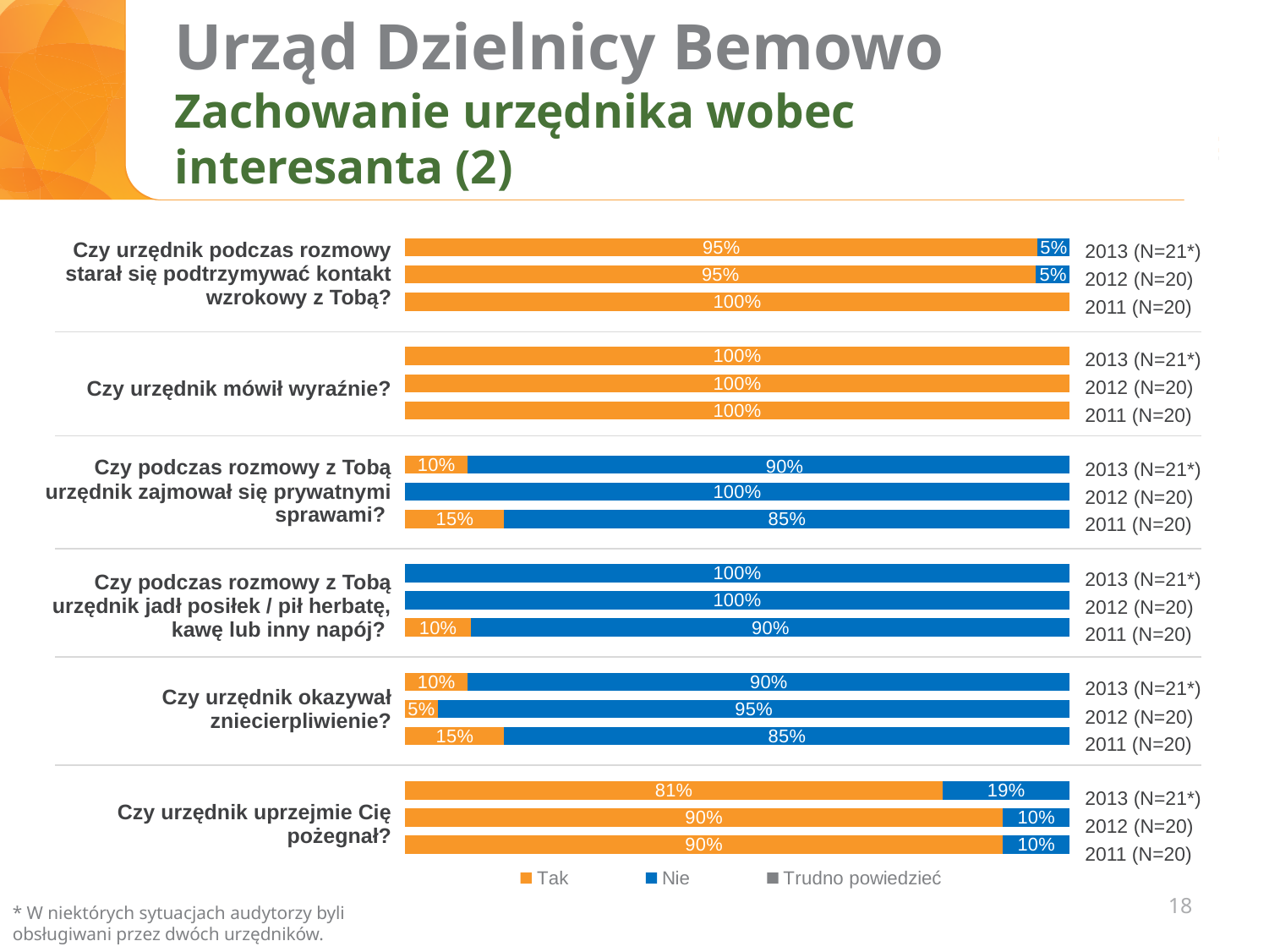
What percentage answered "Tak" to "Czy urzędnik uprzejmie Cię pożegnał?" in 2013? 81% What percentage answered "Tak" to "Czy podczas rozmowy z Tobą urzędnik zajmował się prywatnymi sprawami?" in 2011? 15% What percentage answered "Nie" to "Czy urzędnik okazywał zniecierpliwienie?" in 2011? 85% What is the difference in percentage points between the "Nie" share for "Czy urzędnik uprzejmie Cię pożegnał?" in 2013 and in 2012? 9 percentage points What percentage answered "Nie" to "Czy urzędnik okazywał zniecierpliwienie?" in 2012? 95% How many years (bars) are shown for each question? 3 For "Czy urzędnik uprzejmie Cię pożegnał?", which year had the higher "Tak" share, 2013 or 2011? 2011 How many series does the legend list? 3 What kind of chart is shown on the slide? Stacked bar chart For "Czy urzędnik uprzejmie Cię pożegnał?", which year had the highest "Nie" share? 2013 What are the three legend entries of the chart? Tak, Nie, Trudno powiedzieć What percentage answered "Tak" to "Czy urzędnik podczas rozmowy starał się podtrzymywać kontakt wzrokowy z Tobą?" in 2012? 95%